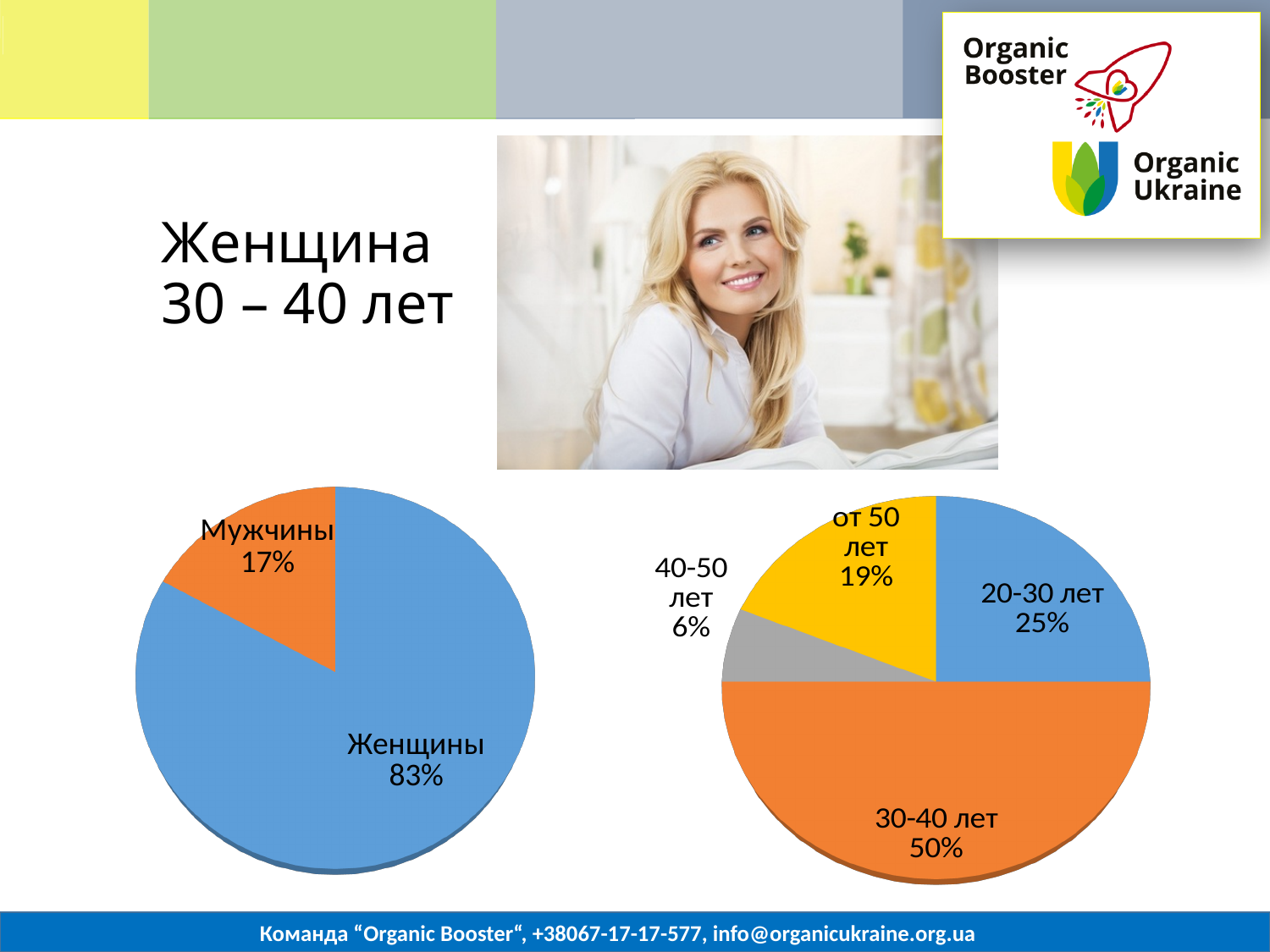
In the left pie chart, what share is labelled for Женщины? 83% In the right pie chart, which is larger: the share for 20-30 лет or the share for от 50 лет? 20-30 лет In the left pie chart, what share is labelled for Мужчины? 17% In the right pie chart, which age group has the smallest share? 40-50 лет In the right pie chart, what share is labelled for 30-40 лет? 50% In the left pie chart, how many slices are there? 2 What type of chart is the chart on the left? Pie chart In the right pie chart, which age group has the largest share? 30-40 лет In the right pie chart, what share is labelled for от 50 лет? 19% In the left pie chart, what is the difference between the Женщины and Мужчины shares? 66% In the right pie chart, how many age groups are shown? 4 In the left pie chart, which slice is the largest? Женщины